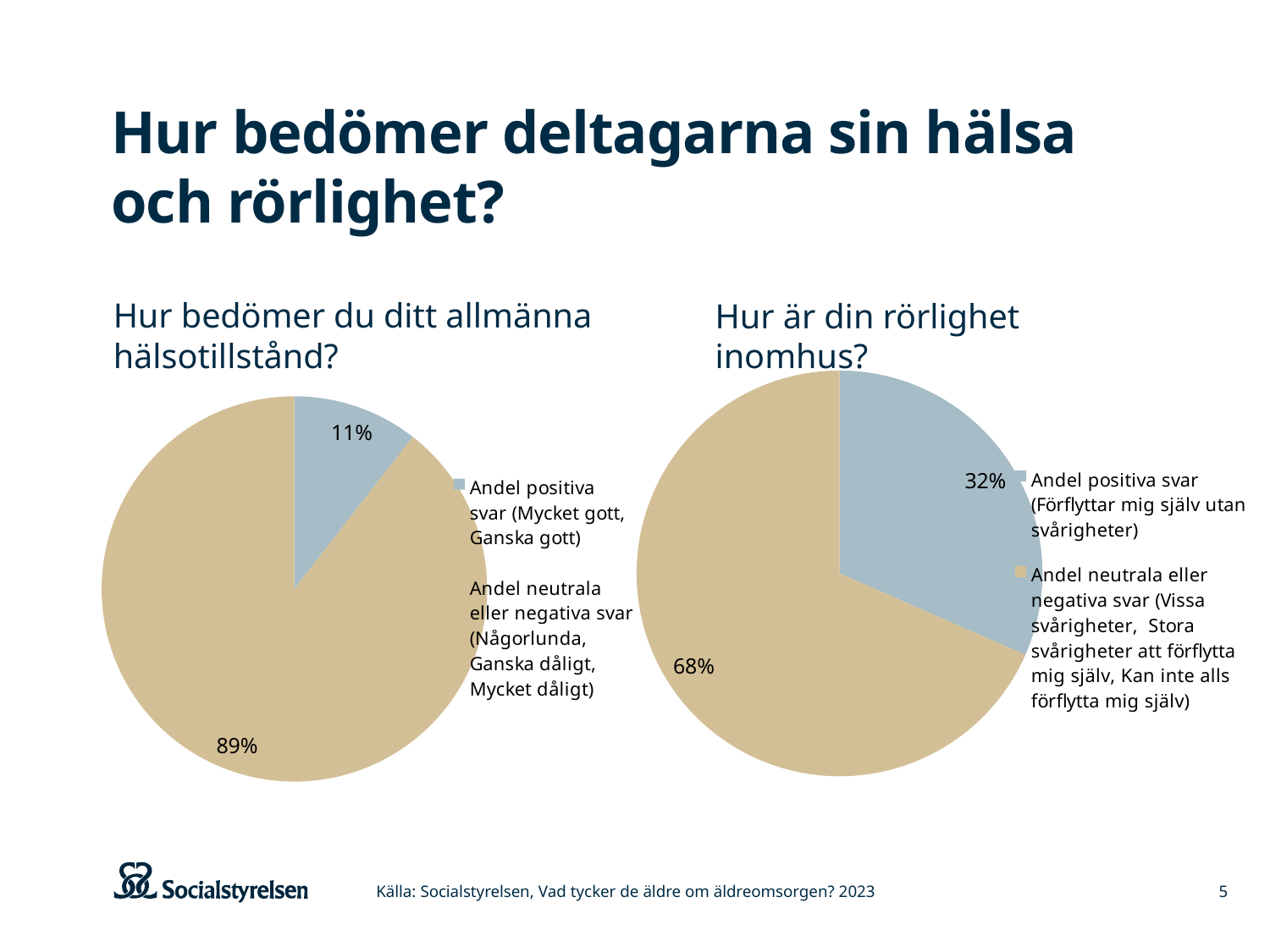
How many slices does the pie chart 'Hur är din rörlighet inomhus?' have? 2 In the right chart 'Hur är din rörlighet inomhus?', what is the difference between the neutral/negative share and the positive share? 36 percentage points In the right chart 'Hur är din rörlighet inomhus?', what share of responses are 'Andel neutrala eller negativa svar'? 68% Which chart has the larger share of 'Andel positiva svar': the left chart on general health or the right chart on indoor mobility? The right chart (Hur är din rörlighet inomhus?) In the left chart 'Hur bedömer du ditt allmänna hälsotillstånd?', what is the difference between the neutral/negative share and the positive share? 78 percentage points In the right chart 'Hur är din rörlighet inomhus?', which category has the smallest slice? Andel positiva svar In the left chart 'Hur bedömer du ditt allmänna hälsotillstånd?', what share of responses are 'Andel neutrala eller negativa svar'? 89% In the right chart 'Hur är din rörlighet inomhus?', what share of responses are 'Andel positiva svar'? 32% How many entries does the legend of the left chart 'Hur bedömer du ditt allmänna hälsotillstånd?' list? 2 What kind of chart is used on this slide for 'Hur bedömer du ditt allmänna hälsotillstånd?'? Pie chart In the left chart 'Hur bedömer du ditt allmänna hälsotillstånd?', what share of responses are 'Andel positiva svar'? 11% In the left chart 'Hur bedömer du ditt allmänna hälsotillstånd?', which category has the largest slice? Andel neutrala eller negativa svar